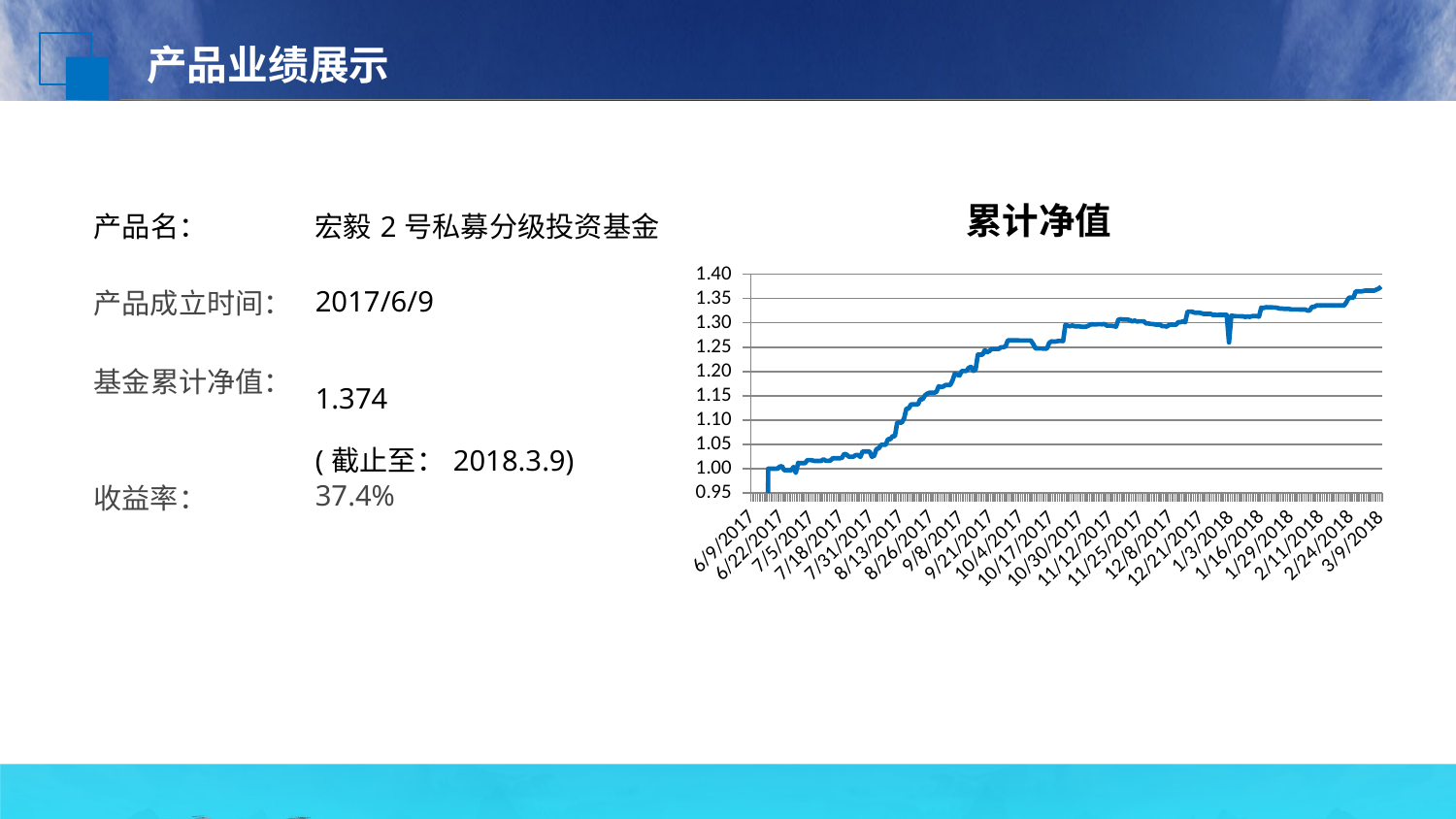
At which date does the 累计净值 chart reach its highest value? 3/9/2018 Is the value at 9/8/2017 in the 累计净值 chart greater or less than 1.10? greater Is the value at 3/9/2018 in the 累计净值 chart greater or less than 1.35? greater Which date has the larger value in the 累计净值 chart, 6/9/2017 or 3/9/2018? 3/9/2018 What is the highest value shown on the y-axis of the 累计净值 chart? 1.40 What is the title of the chart? 累计净值 Is the value at 6/9/2017 in the 累计净值 chart greater or less than 1.05? less Overall, does the line in the 累计净值 chart rise or fall from 6/9/2017 to 3/9/2018? rise What kind of chart is shown on the slide? line chart How many lines (series) are plotted in the 累计净值 chart? 1